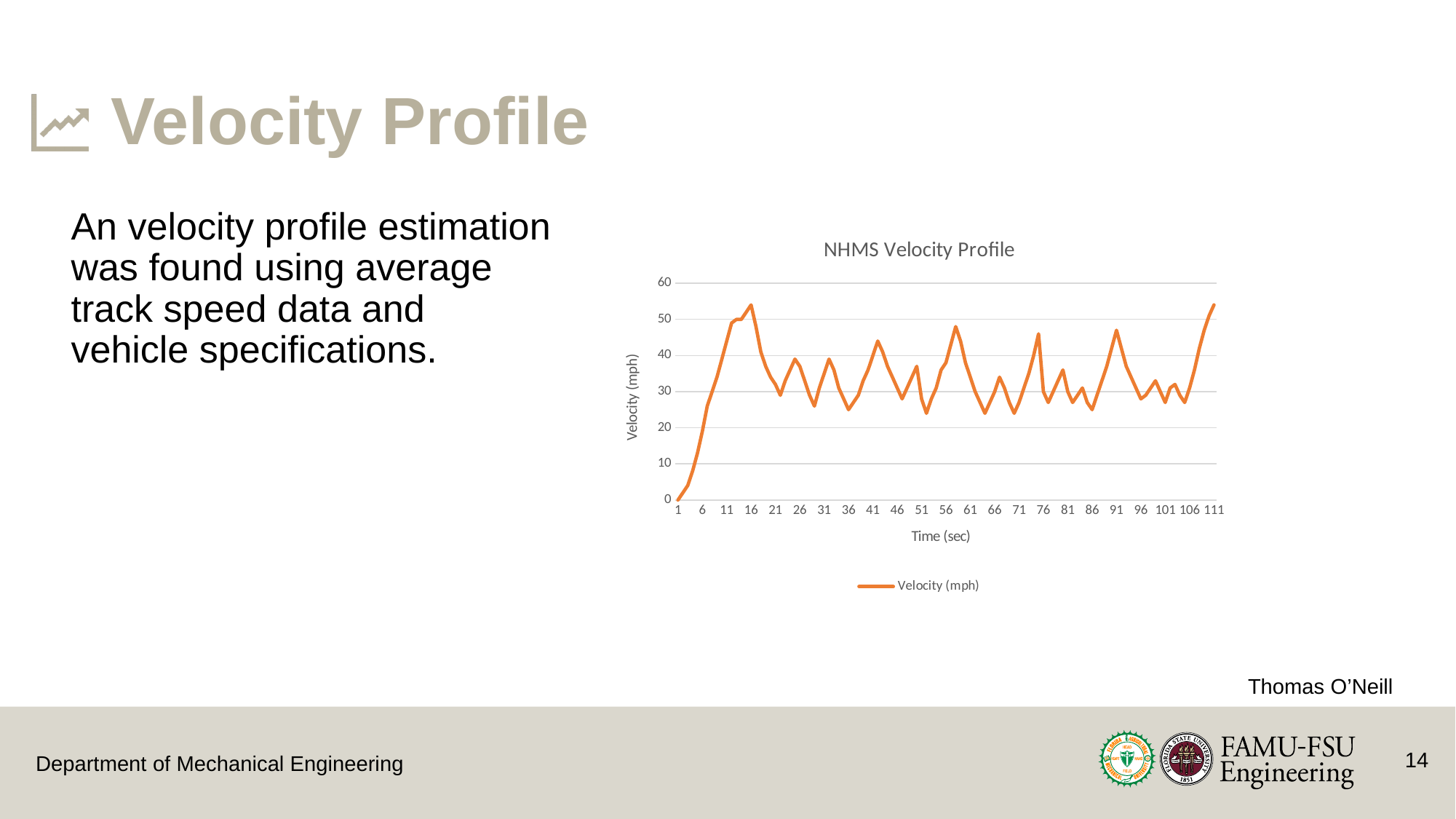
Is the velocity value at time 31 greater or less than 30? greater What is the highest value shown on the vertical axis of the chart? 60 What is the label of the series shown in the legend? Velocity (mph) Does the velocity rise or fall between time 16 and time 21? fall Does the velocity rise or fall between time 1 and time 16? rise Is the velocity value at time 16 greater or less than 50? greater How many series does the chart legend list? 1 Is the velocity value at time 36 greater or less than 30? less What is the title of the chart? NHMS Velocity Profile What kind of chart is shown on the slide? line chart